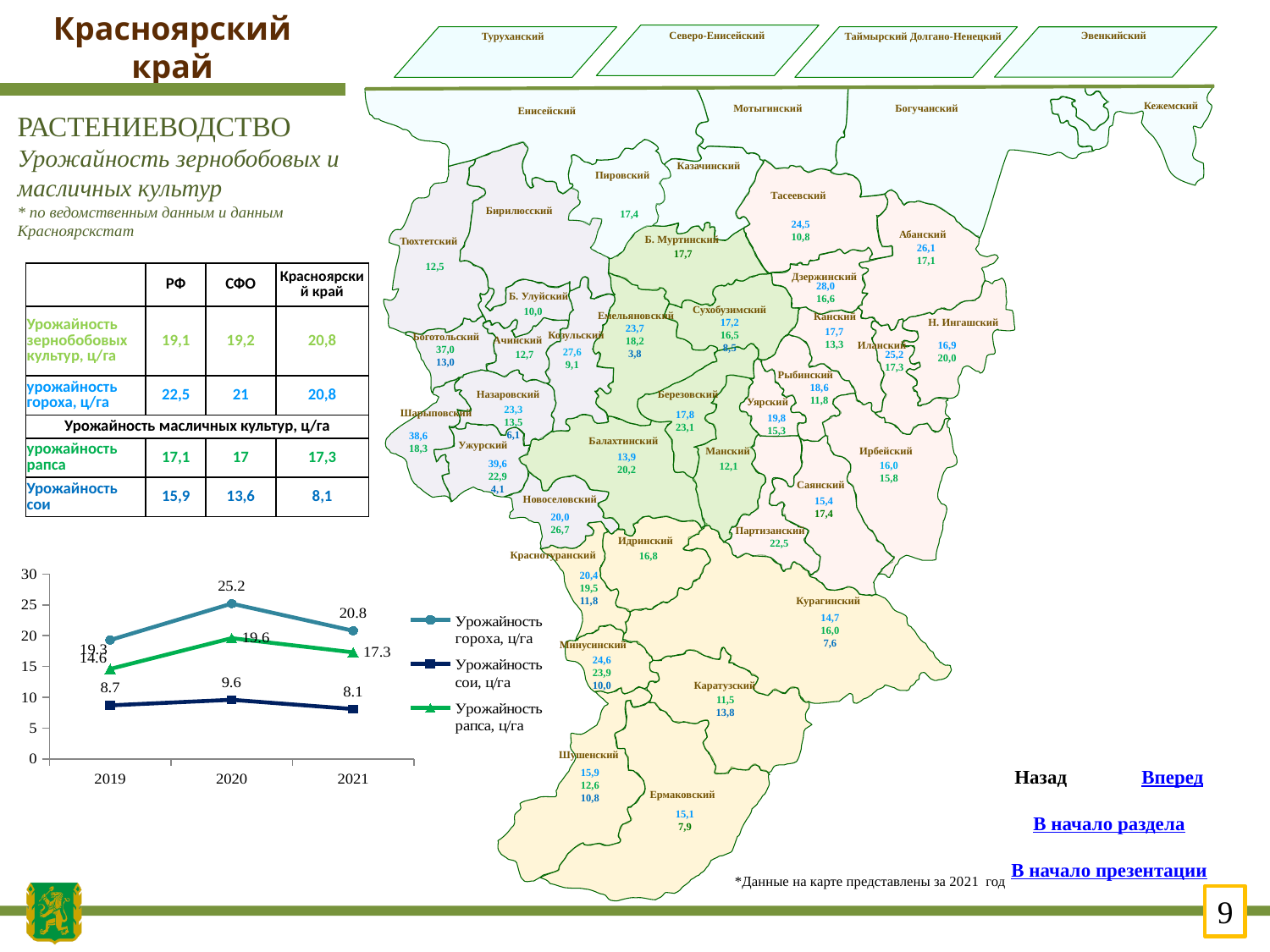
How many series does the legend of the line chart list? 3 In the line chart, what is the value of Урожайность рапса, ц/га in 2019? 14.6 How many years are plotted along the x axis of the line chart? 3 In the line chart, which year has the lowest value for Урожайность сои, ц/га? 2021 In the line chart, what is the difference between Урожайность гороха, ц/га and Урожайность сои, ц/га in 2021? 12.7 In the line chart, does Урожайность рапса, ц/га rise or fall from 2020 to 2021? fall In the line chart, what is the value of Урожайность гороха, ц/га in 2020? 25.2 What type of chart is shown at the bottom left of the slide? line chart In the line chart, which year has the highest value for Урожайность гороха, ц/га? 2020 In the line chart, what is the value of Урожайность сои, ц/га in 2021? 8.1 In the line chart, is the value for Урожайность гороха, ц/га in 2019 greater or less than 20? less In the line chart, which is larger in 2020: Урожайность рапса, ц/га or Урожайность сои, ц/га? Урожайность рапса, ц/га